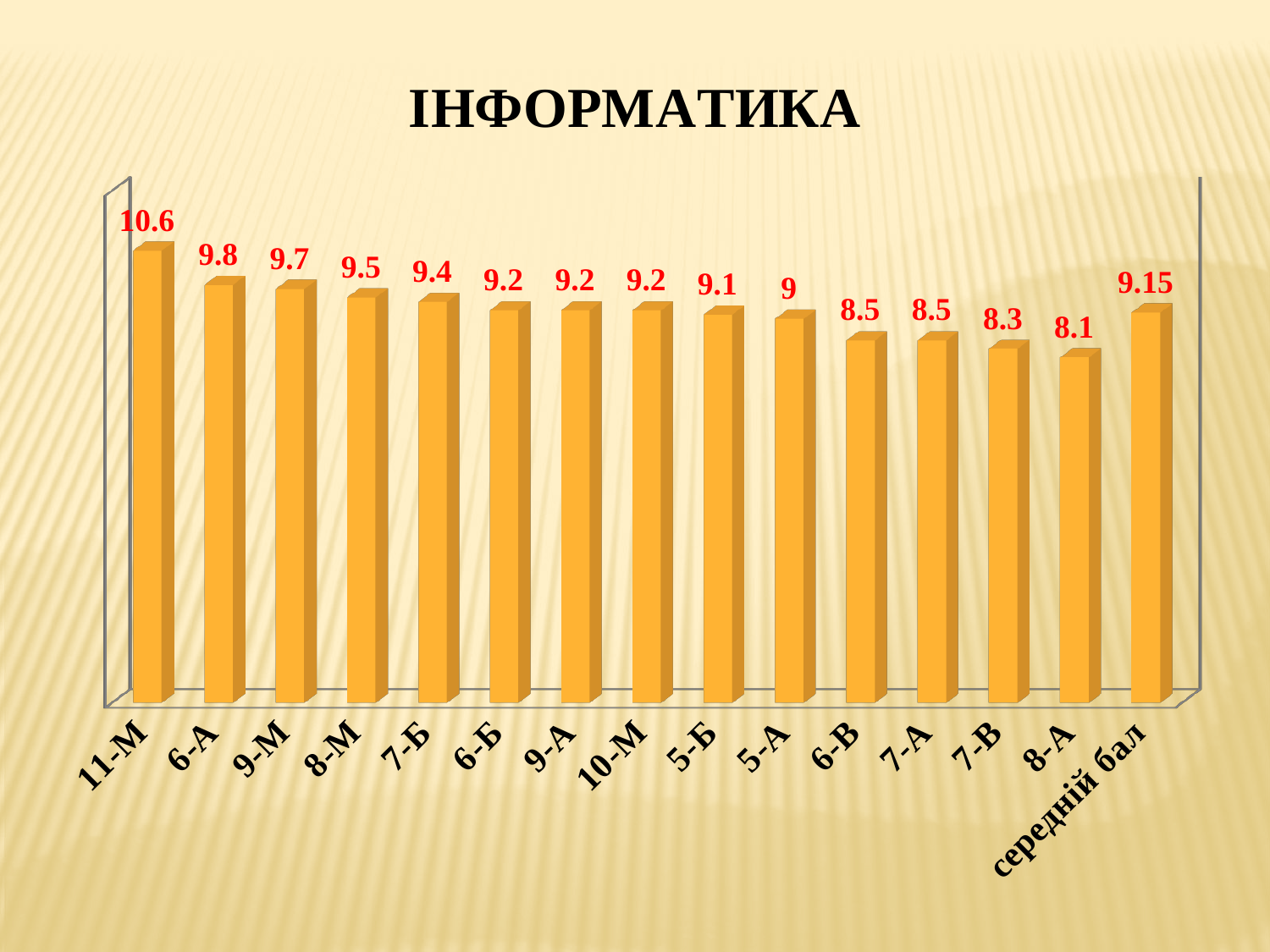
What is the difference between the values for 11-М and 8-А? 2.5 What is the difference between the values for 6-А and 5-А? 0.8 Do the values for the class bars rise or fall from 11-М to 8-А along the x axis? fall Which category has the highest value? 11-М What kind of chart is shown on the slide? bar chart What is the value for 11-М? 10.6 What is the value for середній бал? 9.15 Which category has the lowest value? 8-А Which is larger, the value for 9-М or the value for 6-В? 9-М What is the title of the chart? ІНФОРМАТИКА How many bars are shown in the chart? 15 What is the value for 7-В? 8.3